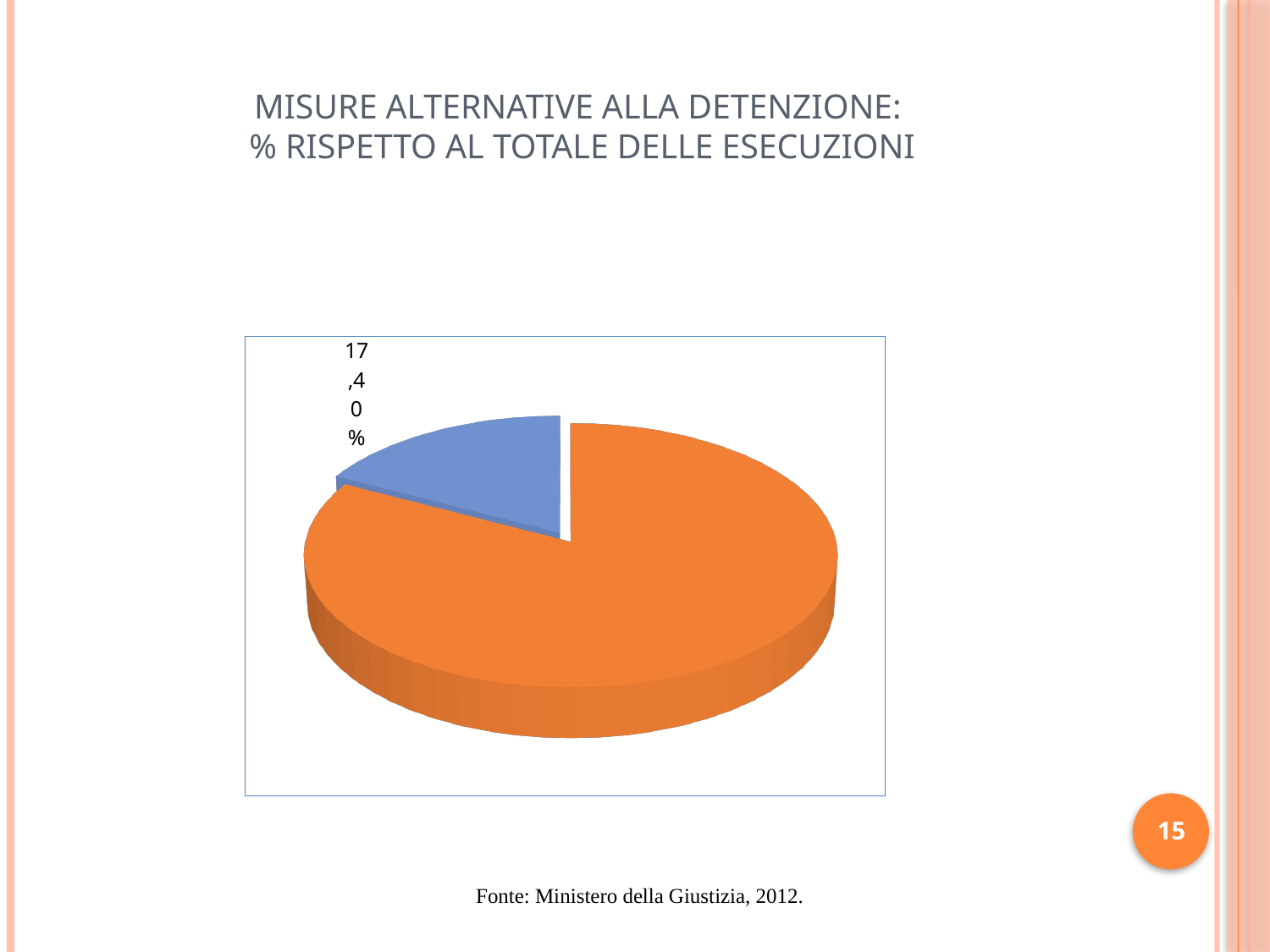
How many slices does the pie chart have? 2 What source is cited below the pie chart? Fonte: Ministero della Giustizia, 2012. What kind of chart is shown on the slide? pie chart Is the share of the orange slice greater or less than 50%? greater Which slice of the pie chart is the largest? the orange slice Which slice of the pie chart is the smallest? the blue slice What value is printed on the blue slice of the pie chart? 17,40% Is the share of the blue slice greater or less than 25%? less Which slice of the pie chart is larger, the orange one or the blue one? orange What is the title of the slide containing the pie chart? MISURE ALTERNATIVE ALLA DETENZIONE: % RISPETTO AL TOTALE DELLE ESECUZIONI